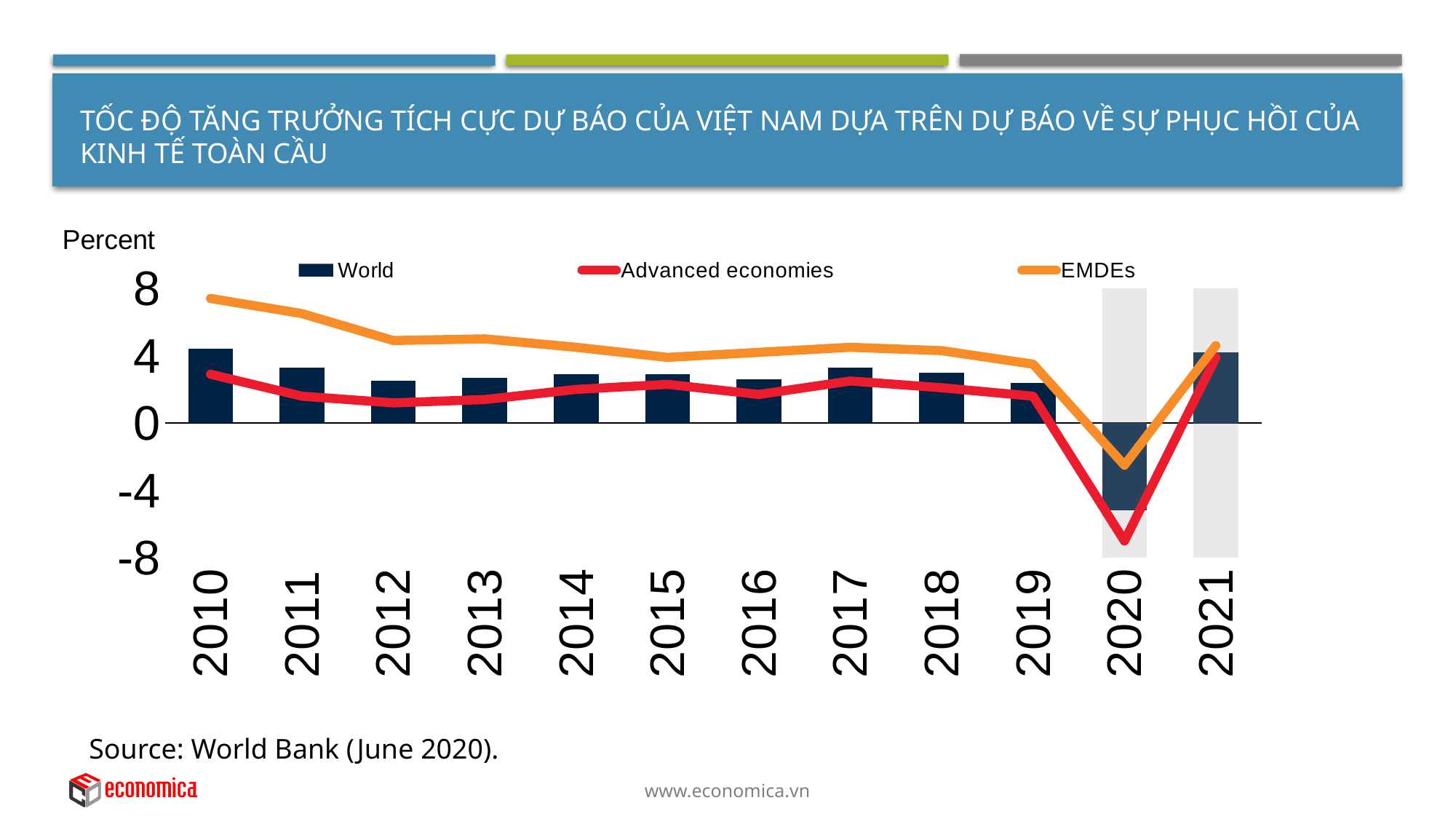
In which year does the Advanced economies line reach its lowest value? 2020 Which series is plotted as bars? World Is the value for World in 2020 greater or less than 0? less Is the value for EMDEs in 2010 greater or less than 4? greater In 2010, which is larger: EMDEs or Advanced economies? EMDEs How many years are shown on the x axis? 12 In which year does the EMDEs line reach its highest value? 2010 Is the value for Advanced economies in 2020 greater or less than -4? less How many series does the legend list? 3 In which year is the World bar lowest? 2020 What unit label is shown above the y axis? Percent What kind of chart is this? Combined bar and line chart